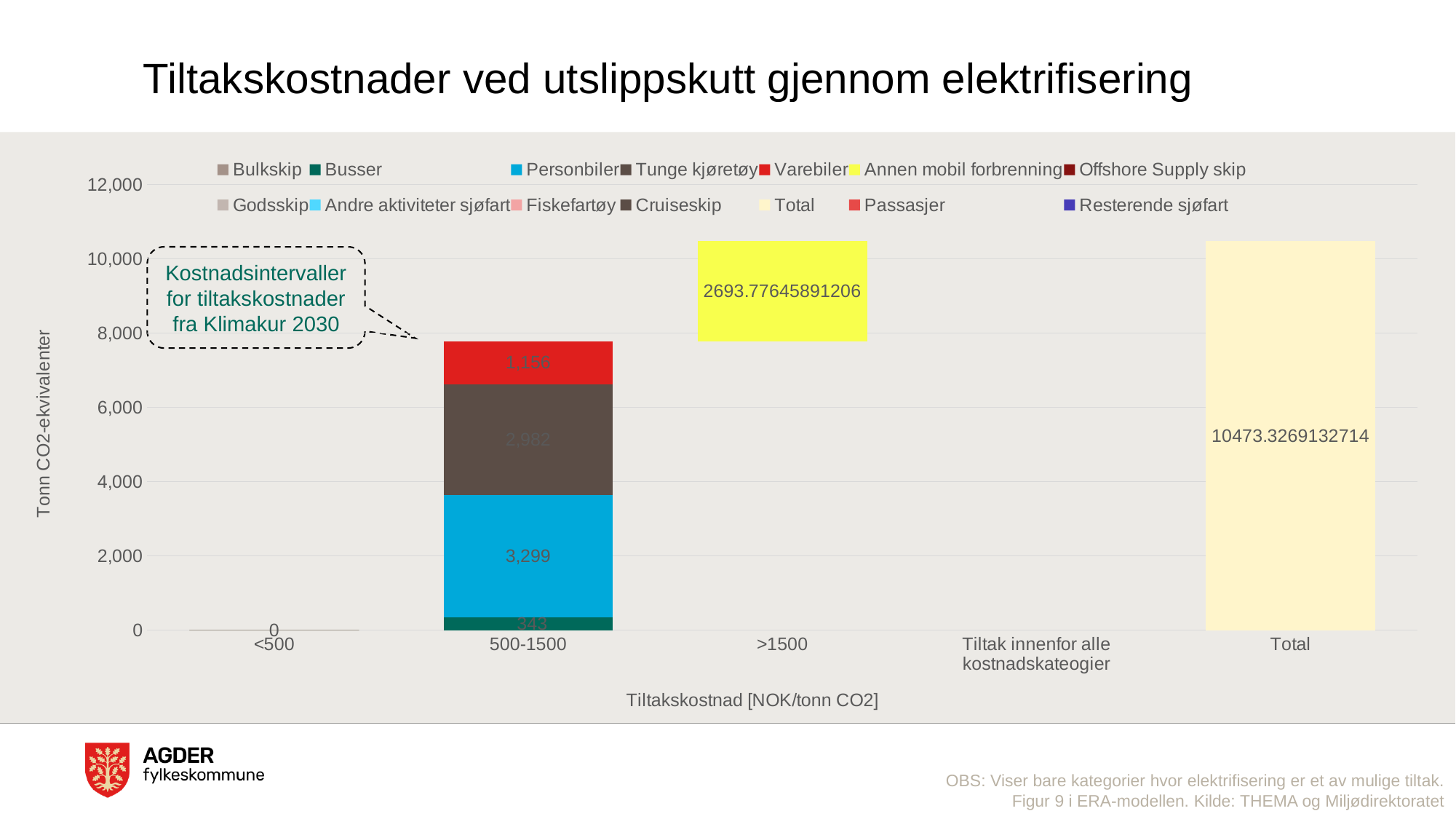
Which segment is largest in the 500-1500 stacked bar? Personbiler What value is shown for the Total bar? 10473.3269132714 How many categories are shown on the x axis? 5 What is the value for Personbiler in the 500-1500 cost category? 3,299 What is the difference between the Personbiler and Tunge kjøretøy values in the 500-1500 category? 317 How many series does the legend list? 14 What is the x-axis title of the chart? Tiltakskostnad [NOK/tonn CO2] What is the total of the stacked bar for the 500-1500 cost category? 7,780 What value is shown for Annen mobil forbrenning in the >1500 cost category? 2693.77645891206 What is the value for Busser in the 500-1500 cost category? 343 What is the value for Tunge kjøretøy in the 500-1500 cost category? 2,982 What is the value for Varebiler in the 500-1500 cost category? 1,156